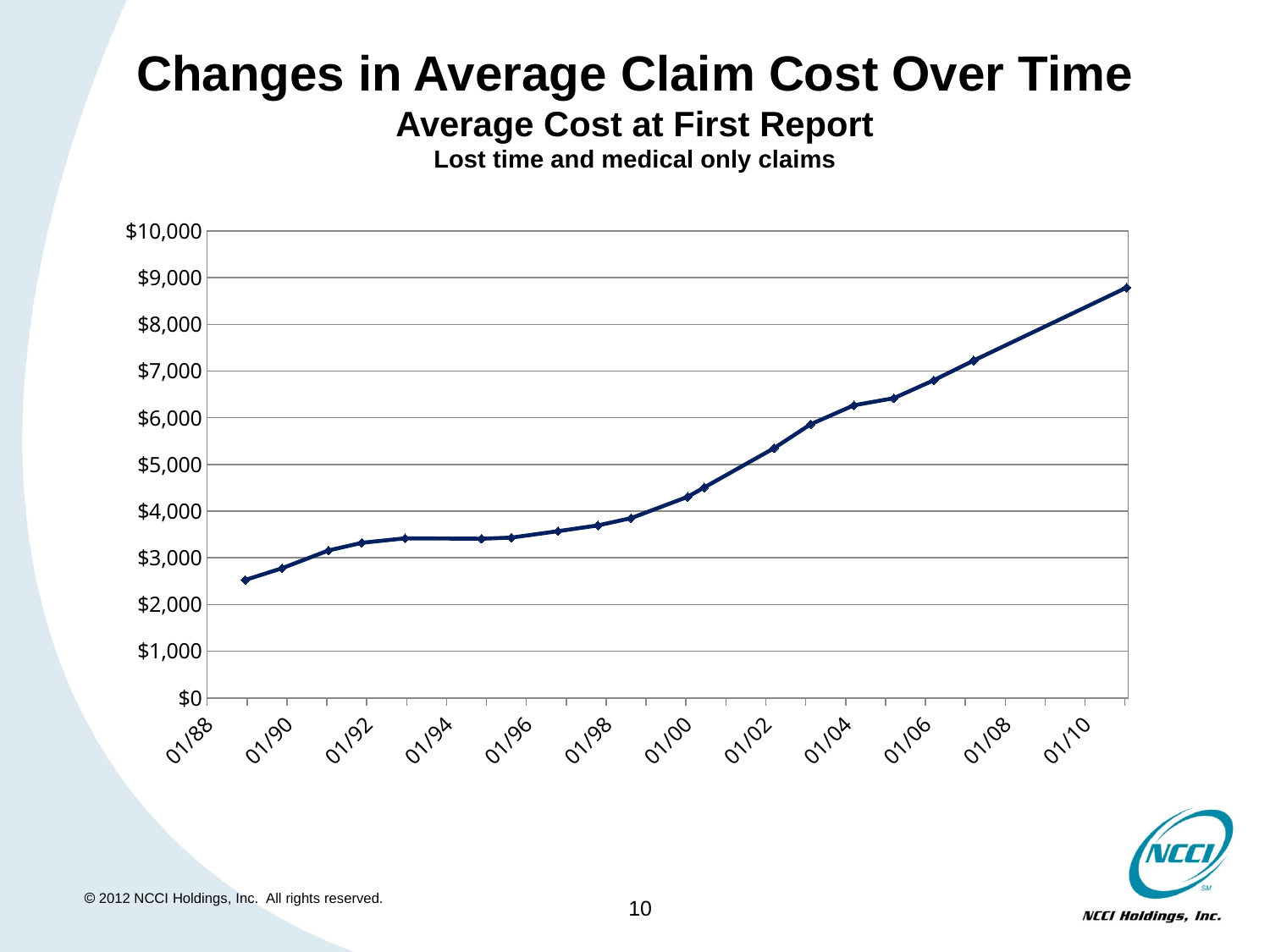
Is the value at 01/90 greater or less than $3,000? less Is the value at 01/06 greater or less than $7,000? less Is the value at 01/98 greater or less than $4,000? less What is the highest value shown on the y axis? $10,000 Do the values generally rise or fall from left to right along the x axis? rise What kind of chart is shown on the slide? line chart